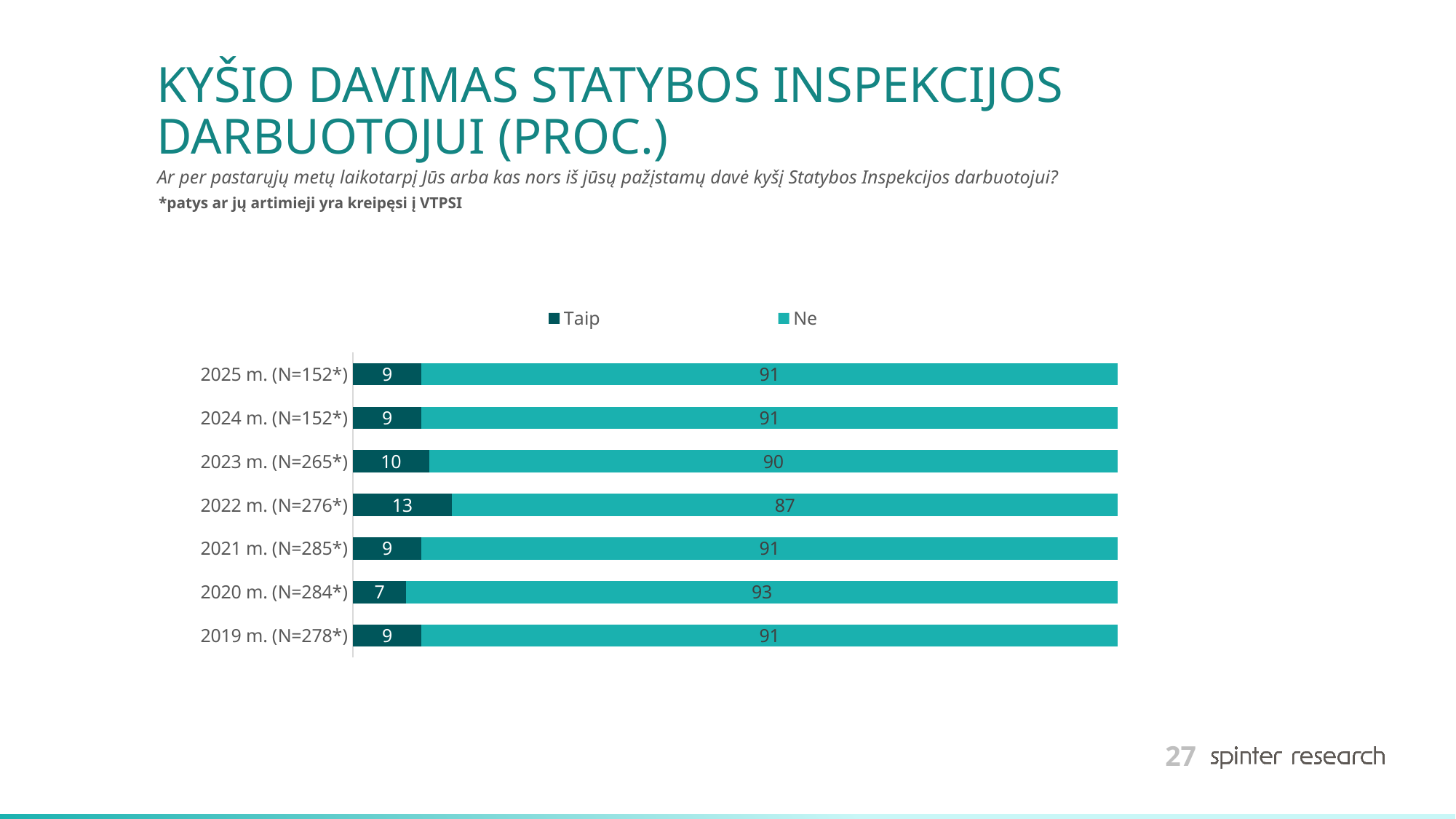
What is the value of "Ne" for 2020 m. (N=284*)? 93 Which year has the lowest "Taip" value? 2020 m. (N=284*) What kind of chart is shown on the slide? Stacked bar chart Which year has the lowest "Ne" value? 2022 m. (N=276*) What is the value of "Taip" for 2023 m. (N=265*)? 10 Which is larger: the "Taip" value for 2023 m. (N=265*) or for 2024 m. (N=152*)? 2023 m. (N=265*) Which year has the highest "Taip" value? 2022 m. (N=276*) What is the difference between the "Taip" values for 2022 m. (N=276*) and 2020 m. (N=284*)? 6 How many years (categories) are shown in the chart? 7 What is the value of "Taip" for 2022 m. (N=276*)? 13 What is the total of the stacked bar for 2025 m. (N=152*)? 100 How many series does the legend list? 2